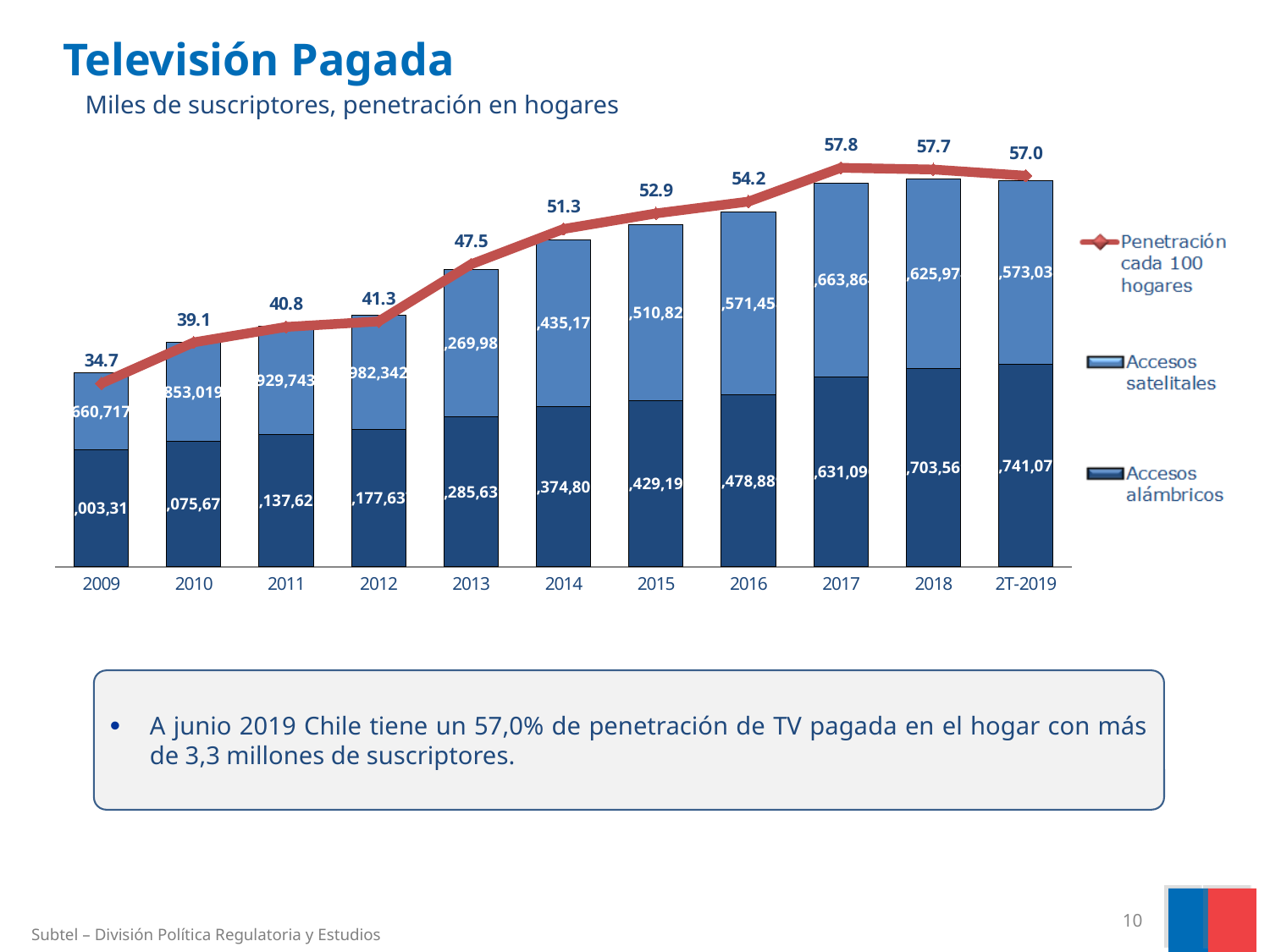
What is the value of Penetración cada 100 hogares for 2T-2019? 57.0 How many series does the legend list? 3 What is the value of Penetración cada 100 hogares for 2009? 34.7 In which year is Penetración cada 100 hogares lowest? 2009 What is the value of Accesos satelitales for 2012? 982,342 In 2009, which is larger, Accesos alámbricos or Accesos satelitales? Accesos alámbricos What is the value of Accesos satelitales for 2009? 660,717 How many time periods are shown on the x axis? 11 Does Penetración cada 100 hogares rise or fall from 2009 to 2017? rise In which year is Penetración cada 100 hogares highest? 2017 Which year has a higher Penetración cada 100 hogares, 2013 or 2014? 2014 What is the difference in Penetración cada 100 hogares between 2017 and 2009? 23.1